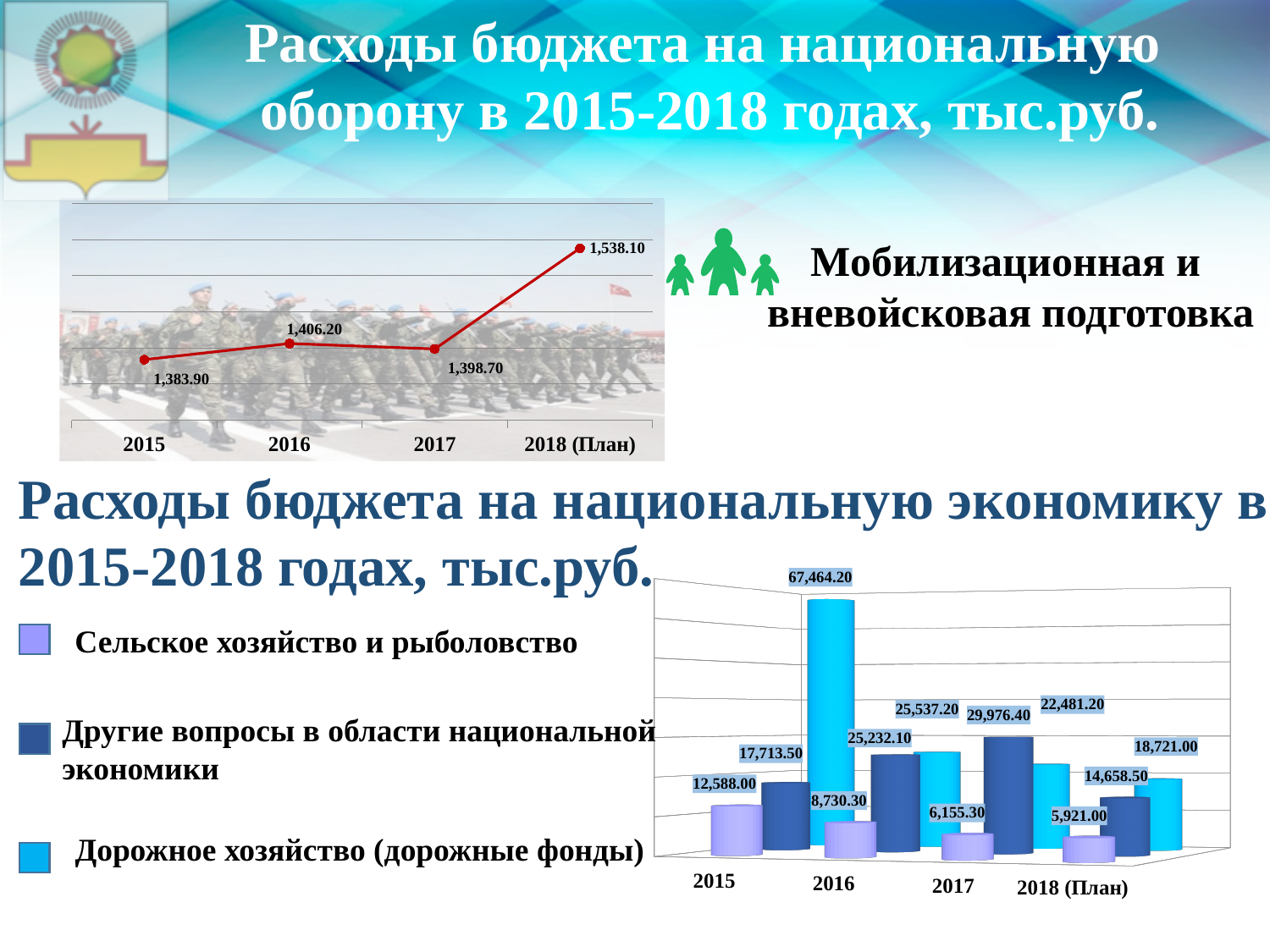
On the bar chart for national economy expenditures, how many series does the legend list? 3 On the bar chart for national economy expenditures, what is the value for Сельское хозяйство и рыболовство in 2018 (План)? 5,921.00 On the bar chart for national economy expenditures, does the value for Сельское хозяйство и рыболовство rise or fall from 2015 to 2018 (План)? Fall On the line chart for national defense expenditures, which year has the highest value? 2018 (План) On the line chart for national defense expenditures, which year has the lowest value? 2015 On the line chart for national defense expenditures, what is the value for 2018 (План)? 1,538.10 On the line chart for national defense expenditures, what is the difference between the 2016 and 2017 values? 7.50 On the bar chart for national economy expenditures, what is the highest value shown? 67,464.20 On the line chart for national defense expenditures, what is the value for 2015? 1,383.90 On the line chart for national defense expenditures, how many data points are plotted? 4 What type of chart is the upper chart on national defense expenditures? Line chart What type of chart is the lower chart on national economy expenditures? Bar chart